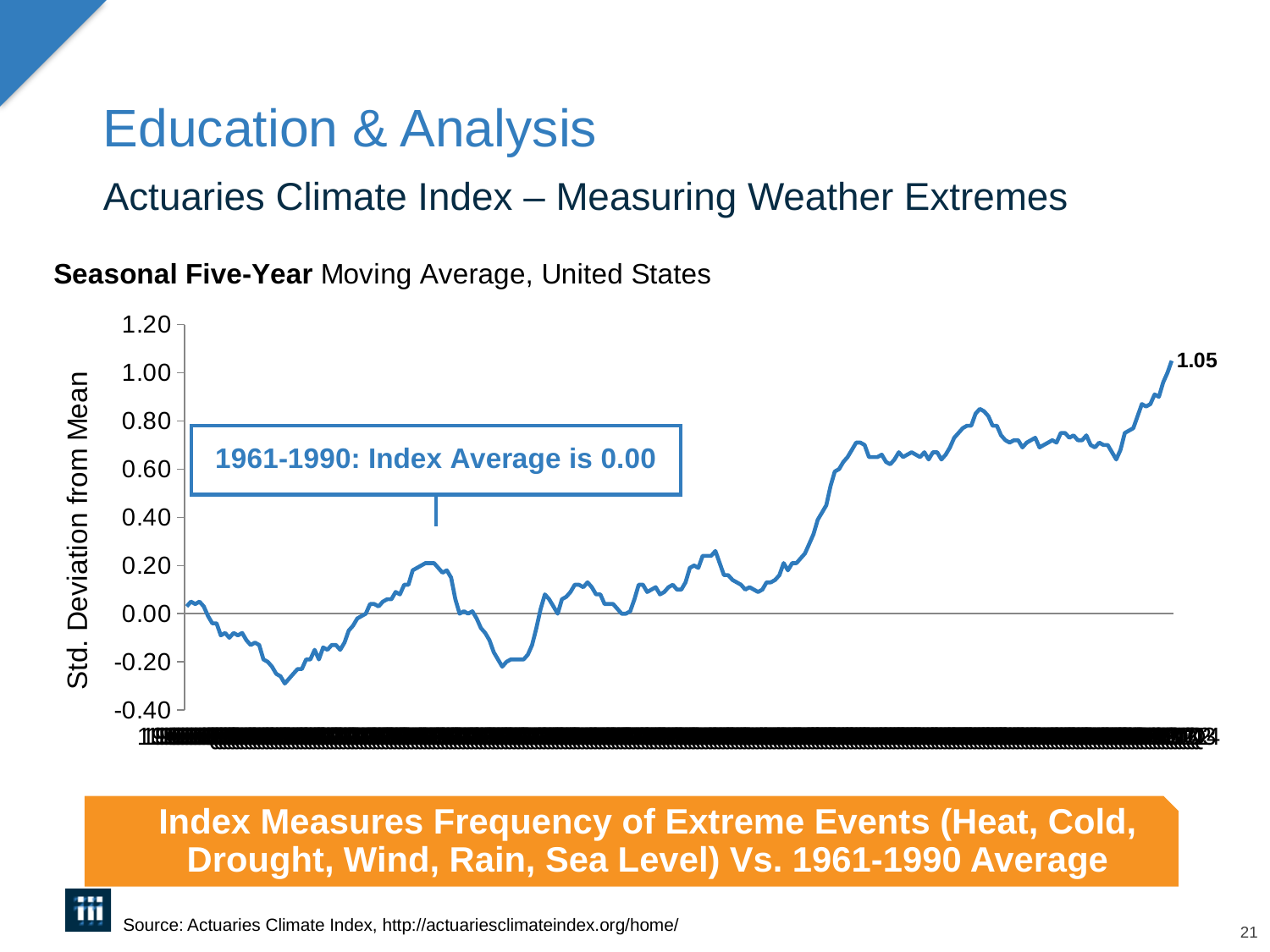
What is the highest tick value shown on the vertical axis? 1.20 What is the label on the vertical axis of the chart? Std. Deviation from Mean What is the highest value reached by the line, as labelled on the chart? 1.05 Is the final value of the line greater or less than 1.00? greater What is the lowest tick value shown on the vertical axis? -0.40 What kind of chart is shown on the slide? Line chart Is the lowest point of the line greater or less than -0.20? less Overall, does the line rise or fall from left to right across the chart? Rise What is the value printed at the end of the line in the Seasonal Five-Year Moving Average chart? 1.05 According to the annotation box on the chart, what is the index average for 1961-1990? 0.00 How many lines (series) are plotted on the chart? 1